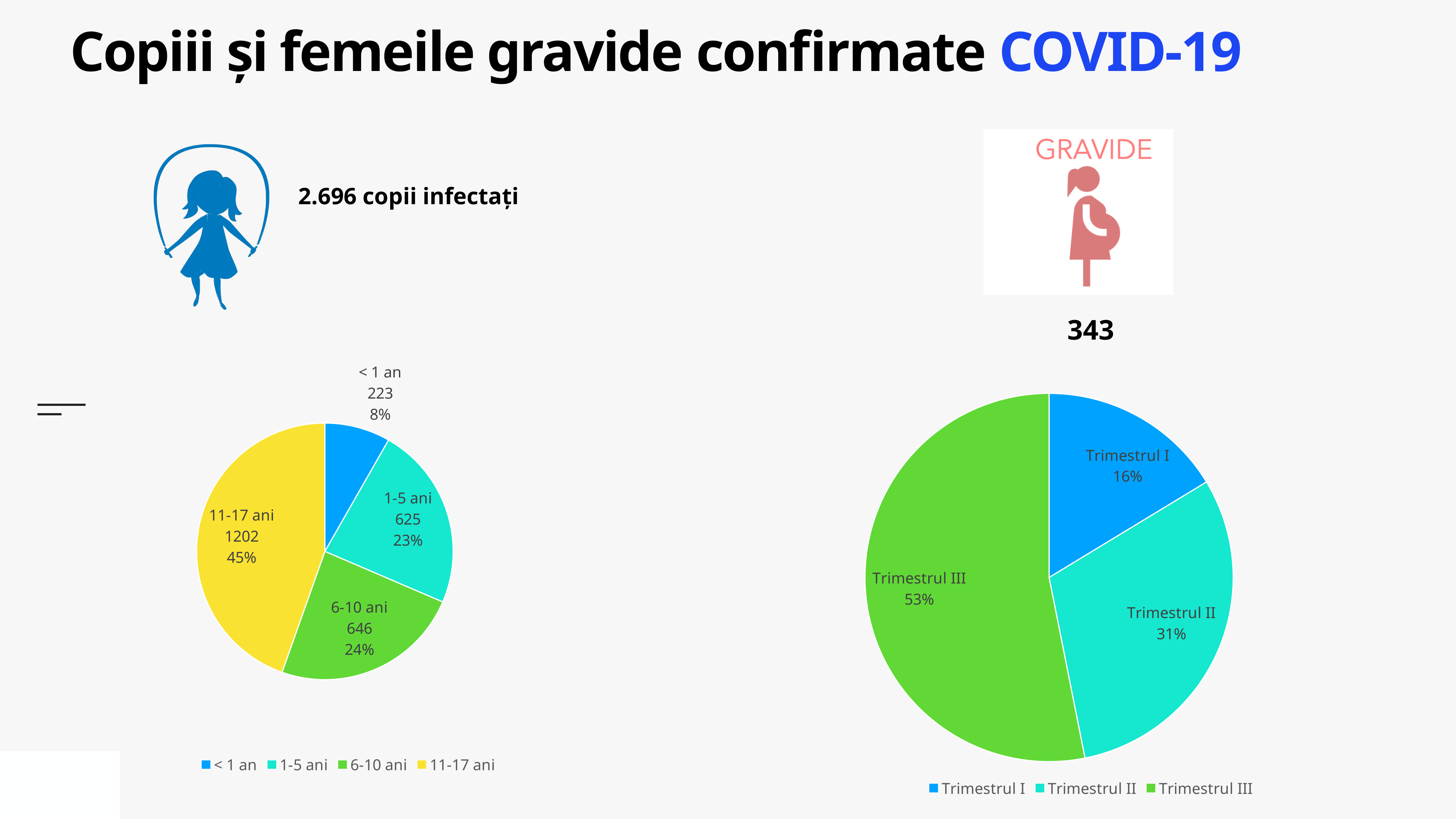
What type of chart is the chart on the right side of the slide? Pie chart In the left pie chart (children by age group), which age group has the smallest slice? < 1 an In the left pie chart (children by age group), what percentage share does the 1-5 ani slice have? 23% In the right pie chart (pregnant women by trimester), which trimester has the smallest share? Trimestrul I In the left pie chart (children by age group), how many age groups are shown? 4 In the left pie chart (children by age group), what is the value for < 1 an? 223 In the right pie chart (pregnant women by trimester), what share does Trimestrul III have? 53% In the right pie chart (pregnant women by trimester), how many entries does the legend list? 3 In the left pie chart (children by age group), which age group has the largest slice? 11-17 ani In the right pie chart (pregnant women by trimester), which is larger, Trimestrul II or Trimestrul I? Trimestrul II In the left pie chart (children by age group), what is the difference between the 6-10 ani and 1-5 ani counts? 21 In the left pie chart (children by age group), how many infected children are in the 11-17 ani group? 1202